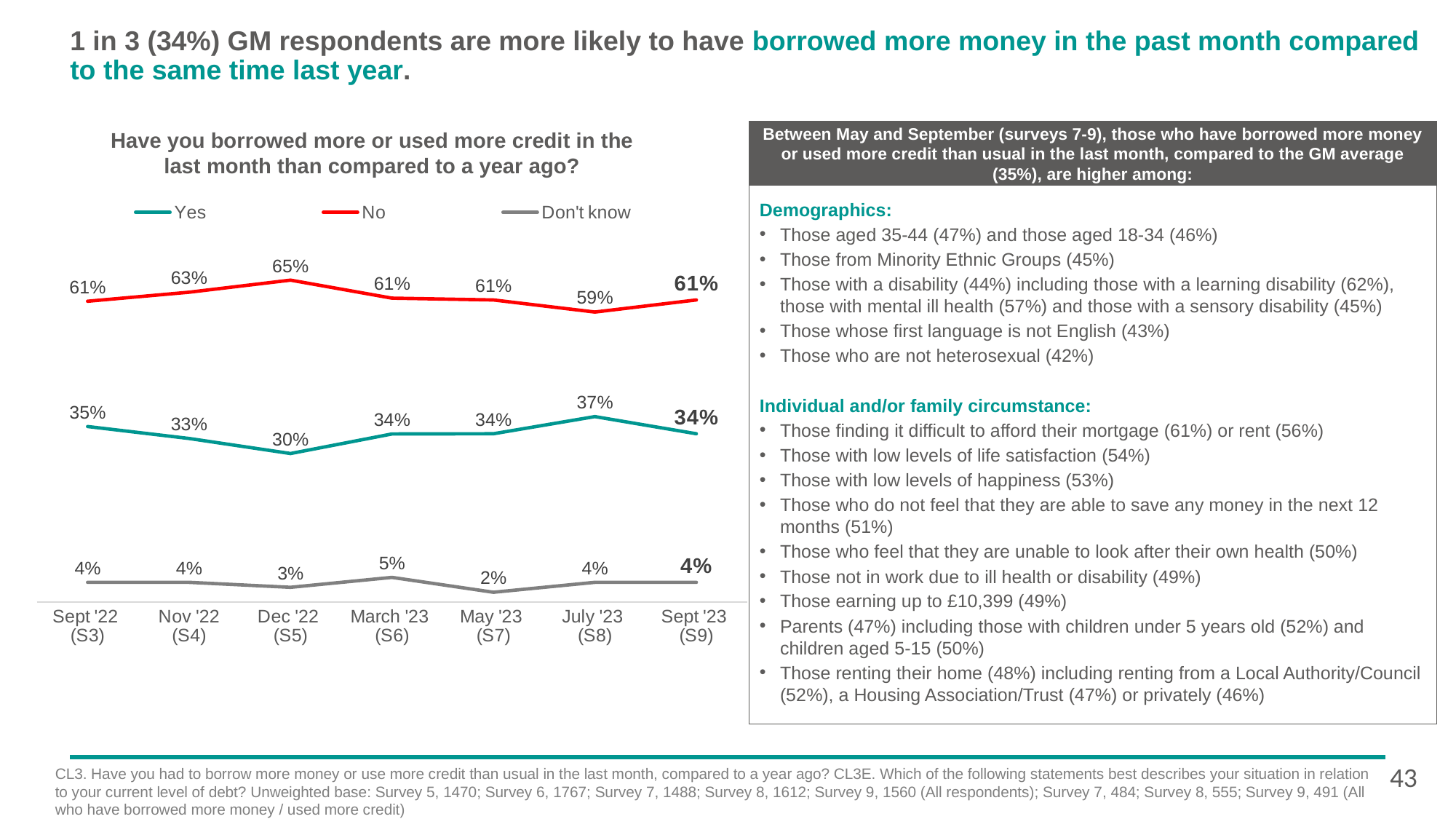
In which survey period is the 'No' series highest? Dec '22 (S5) What is the difference between the 'No' and 'Yes' values in Sept '23 (S9)? 27 percentage points What colour is the 'Yes' line? Teal Which is larger in Dec '22 (S5): the 'Yes' value or the 'No' value? No In which survey period is the 'Yes' series lowest? Dec '22 (S5) What kind of chart is shown? Line chart What is the value for 'Don't know' in May '23 (S7)? 2% What is the value for 'Yes' in Sept '23 (S9)? 34% What is the value for 'No' in Dec '22 (S5)? 65% In which survey period is the 'Yes' series highest? July '23 (S8) How many survey periods are shown on the x axis? 7 How many series does the legend list? 3